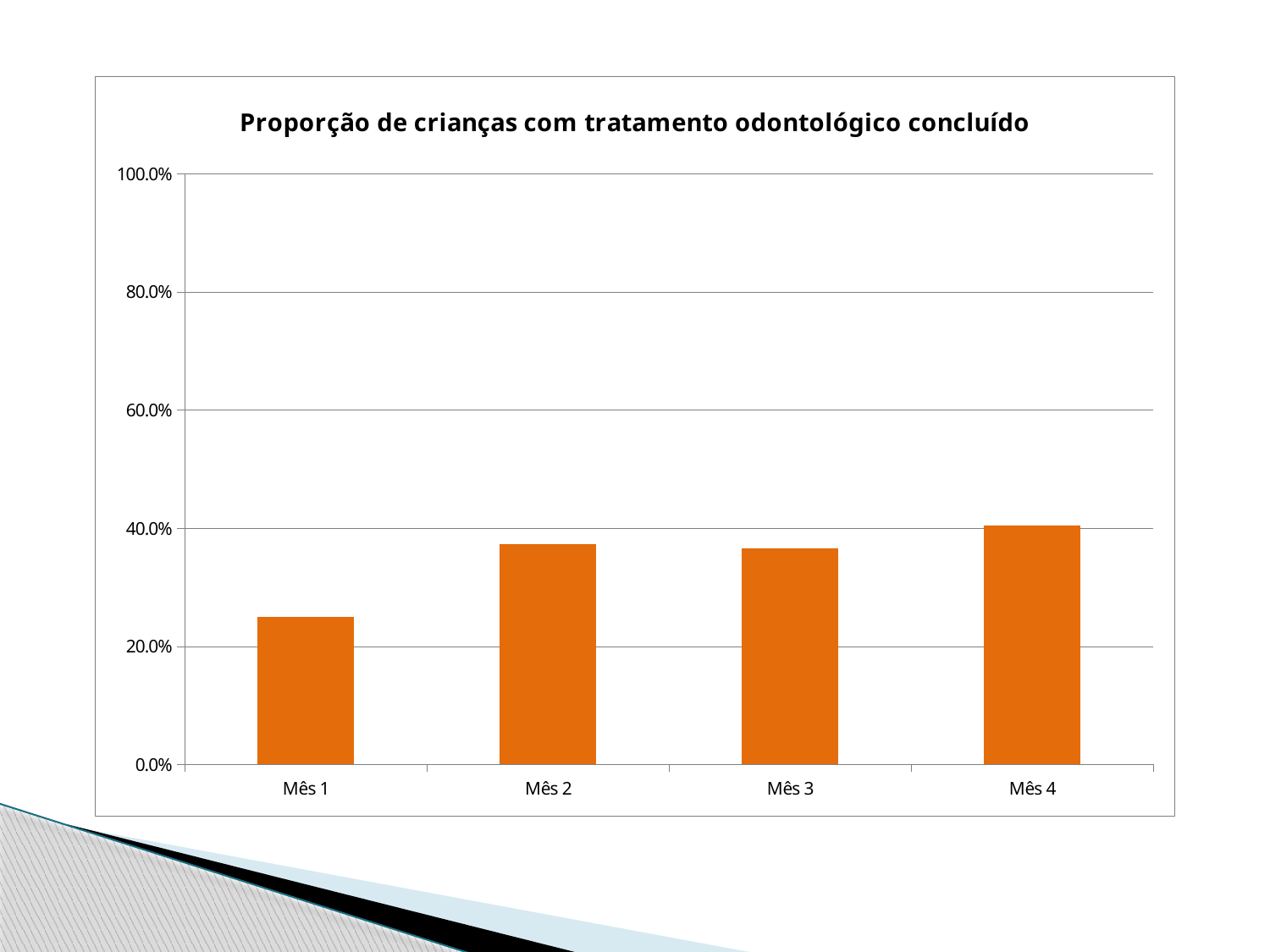
Is the value for Mês 3 greater or less than 20.0%? greater Is the value for Mês 1 greater or less than 20.0%? greater How many categories (months) are plotted on the chart? 4 Which month has the highest proportion of children with completed dental treatment? Mês 4 Which month has the lowest proportion of children with completed dental treatment? Mês 1 Which is larger, the value for Mês 1 or the value for Mês 2? Mês 2 Is the value for Mês 1 greater or less than 40.0%? less What kind of chart is shown on the slide? bar chart Which is larger, the value for Mês 4 or the value for Mês 1? Mês 4 What is the title of the chart? Proporção de crianças com tratamento odontológico concluído What colour are the bars in the chart? orange